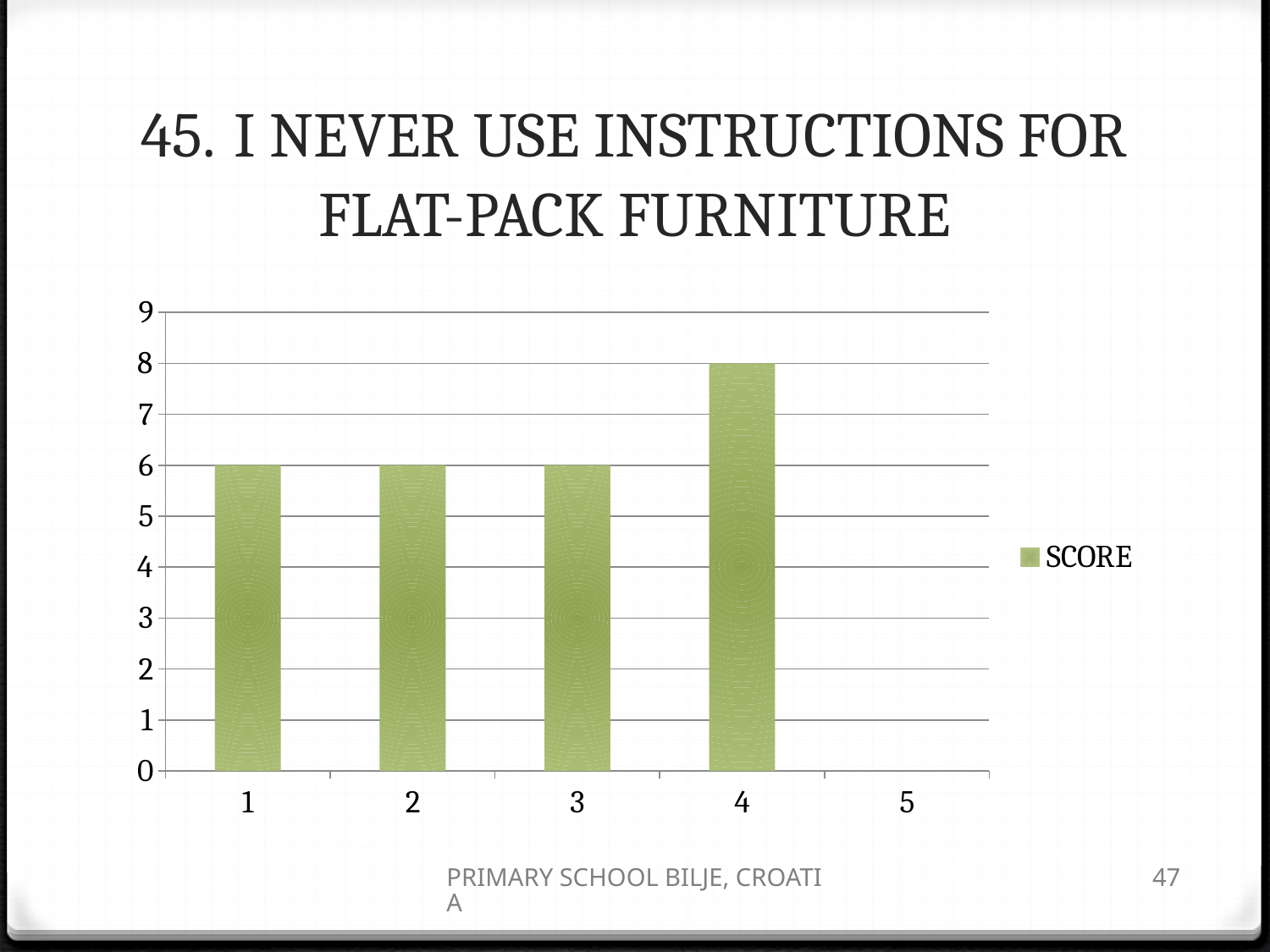
What is the difference between the SCORE for category 4 and the SCORE for category 2? 2 What is the SCORE value for category 3? 6 Is the SCORE for category 2 greater or less than 7? less What is the SCORE value for category 1? 6 What is the highest value shown on the vertical axis? 9 What type of chart is shown on the slide? bar chart How many categories are shown on the x axis? 5 What is the name of the series shown in the legend? SCORE What is the SCORE value for category 4? 8 How many series does the legend list? 1 Which category has the highest SCORE? 4 Which has a larger SCORE, category 4 or category 3? category 4